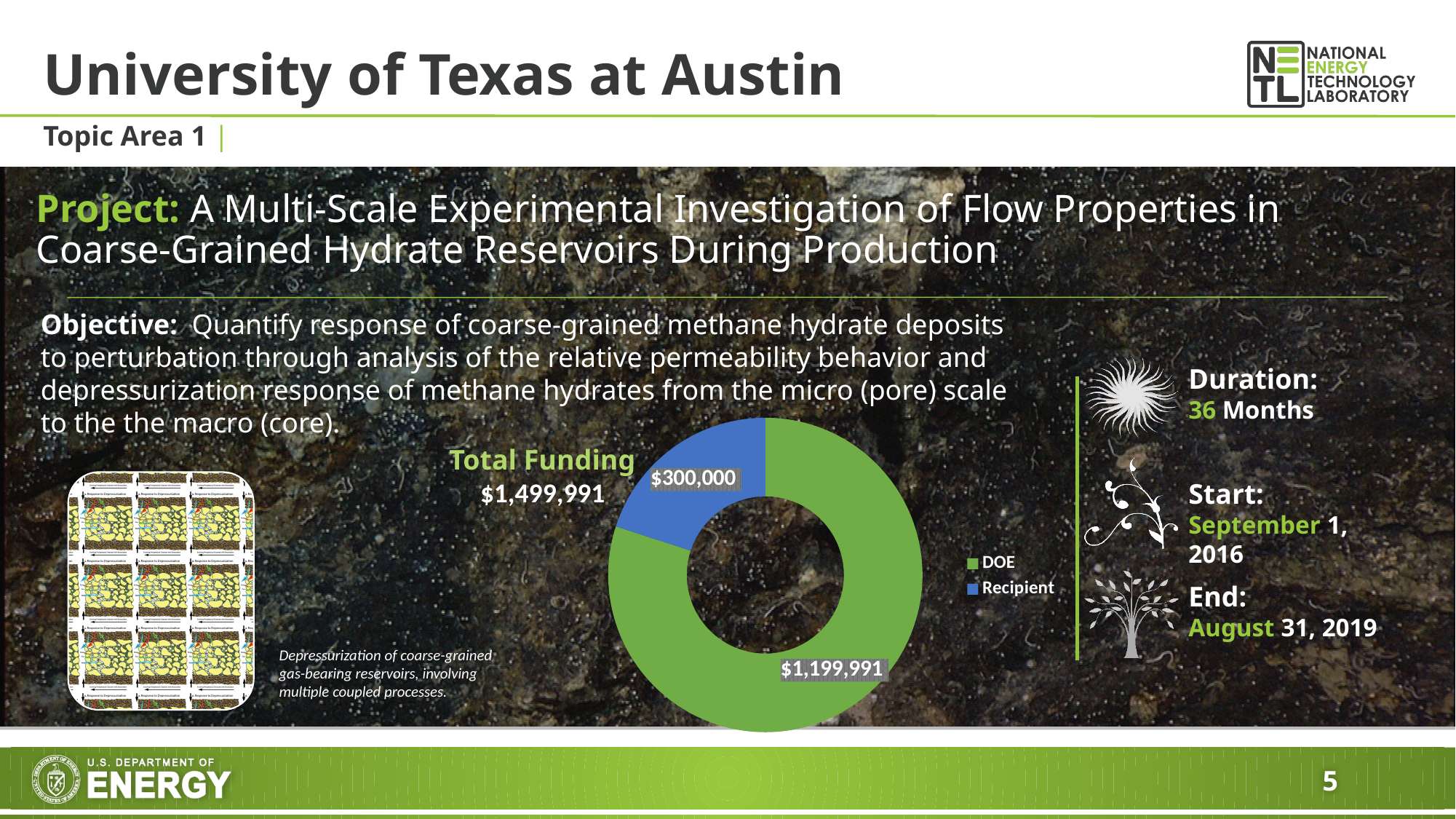
What is the Recipient funding amount shown on the donut chart? $300,000 What colour is the DOE slice in the funding chart? green How many slices does the funding chart have? 2 What kind of chart is used to show the funding split? pie (donut) chart What share of the total funding does the Recipient slice represent? 20% How many entries does the legend of the funding chart list? 2 What is the difference between the DOE and Recipient funding amounts? $899,991 Is the DOE slice larger or smaller than the Recipient slice? larger What is the total funding shown next to the chart? $1,499,991 Which category has the smaller slice in the funding chart? Recipient Which category has the larger slice in the funding chart? DOE What is the DOE funding amount shown on the donut chart? $1,199,991